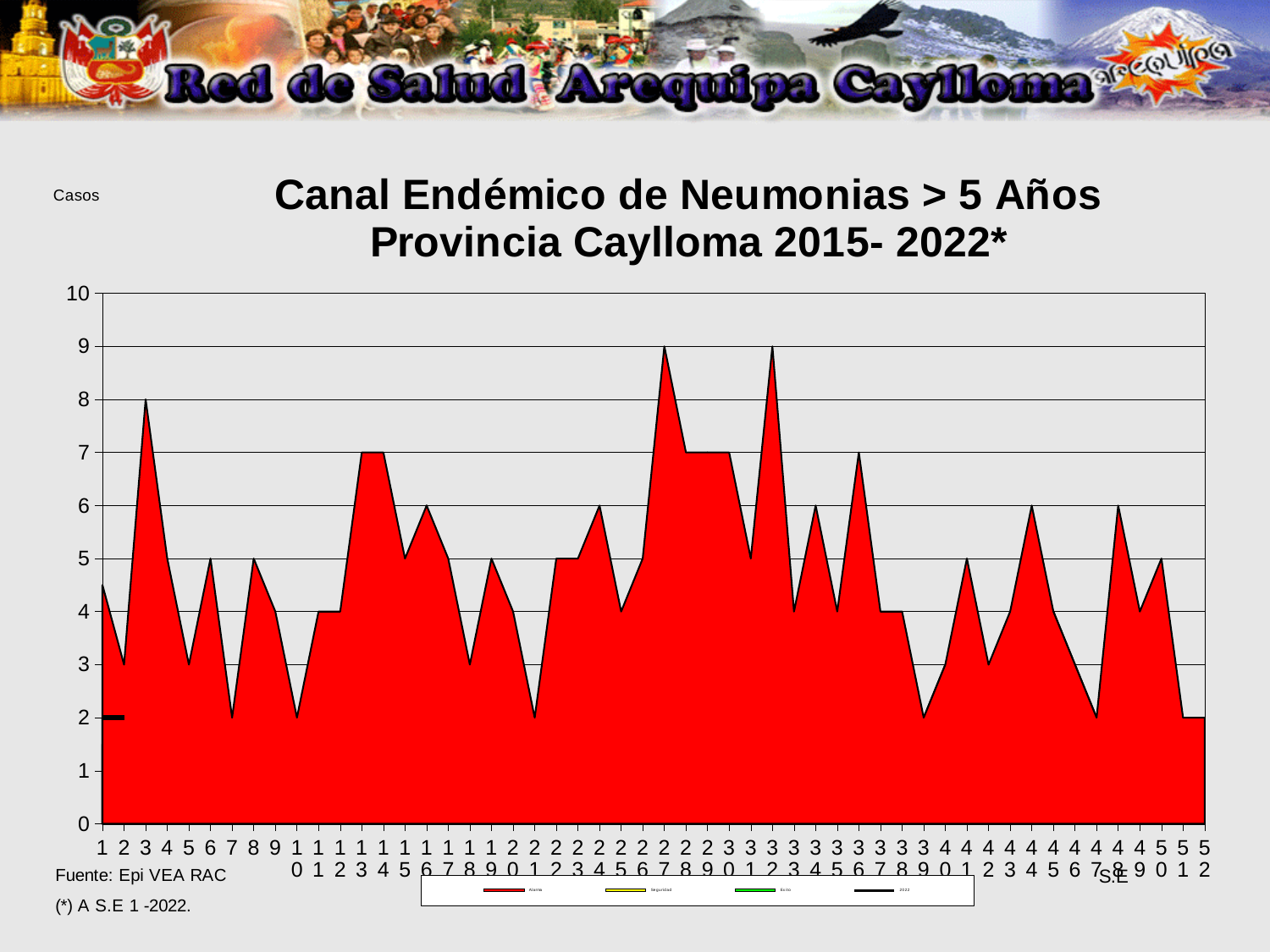
What is the highest value reached by the red Alarma area? 9 What is the value of the red Alarma area at week 3? 8 How many epidemiological weeks (S.E) are shown along the x axis? 52 What is the value of the red Alarma area at week 27? 9 What is the value of the black 2022 line at week 1? 2 What is the lowest value reached by the red Alarma area? 2 Is the value of the red Alarma area at week 7 greater or less than 5? less Is the value of the red Alarma area at week 32 greater or less than 5? greater What is the title of the chart? Canal Endémico de Neumonias > 5 Años Provincia Caylloma 2015- 2022* How many series does the legend list? 4 What source is cited below the chart? Epi VEA RAC What kind of chart is shown on the slide? area chart